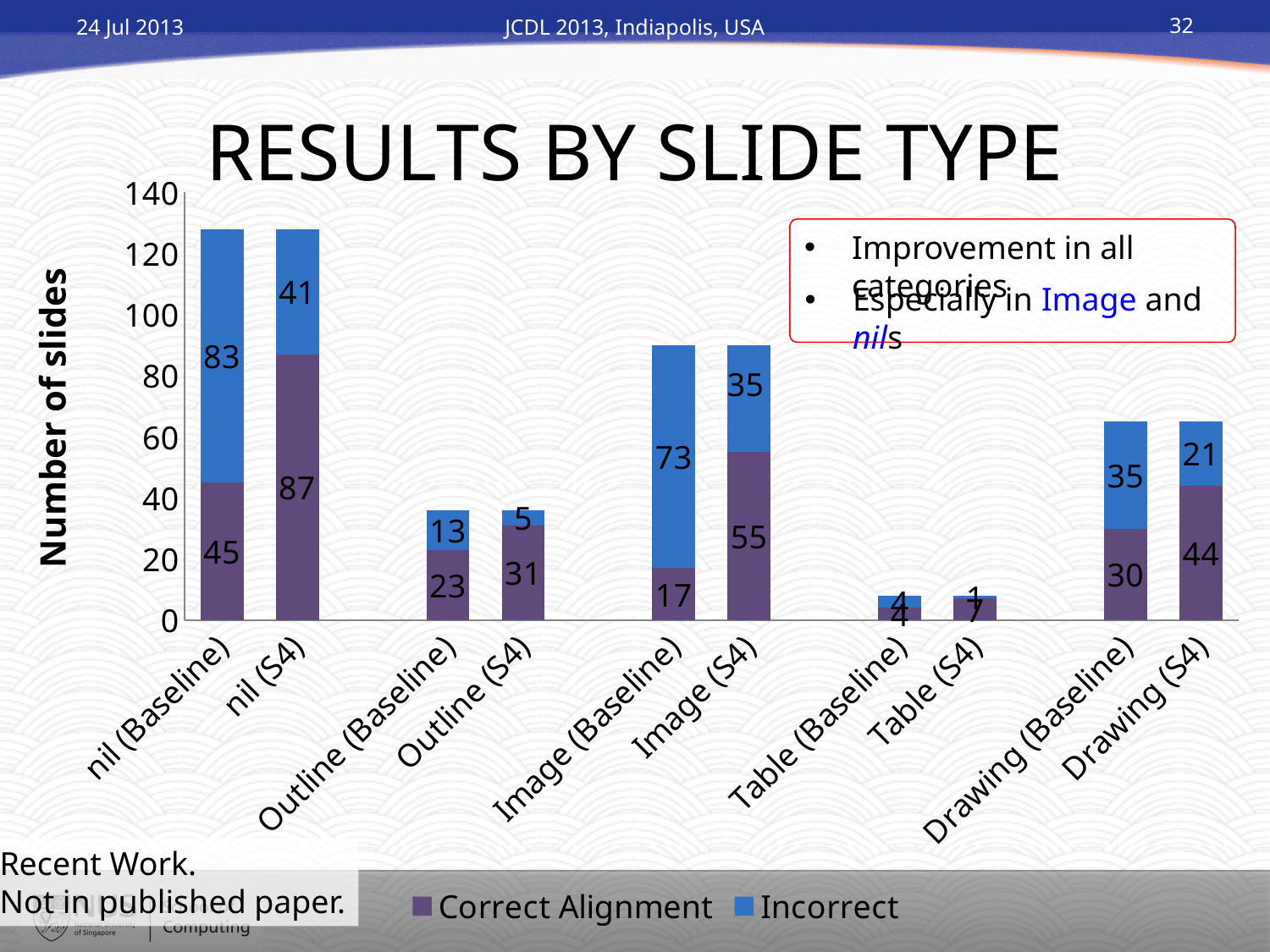
What is the Incorrect value for Image (Baseline)? 73 Which category has the highest Correct Alignment value? nil (S4) What is the total number of slides for the nil (Baseline) bar? 128 How many categories are shown on the x axis? 10 What is the difference between the Correct Alignment values for nil (S4) and nil (Baseline)? 42 What type of chart is shown on the slide? Stacked bar chart What is the Correct Alignment value for Drawing (S4)? 44 Which is larger, the Incorrect value for Image (Baseline) or for Image (S4)? Image (Baseline) Which category has the highest Incorrect value? nil (Baseline) How many series does the legend list? 2 What is the Incorrect value for Outline (S4)? 5 What is the Correct Alignment value for nil (S4)? 87